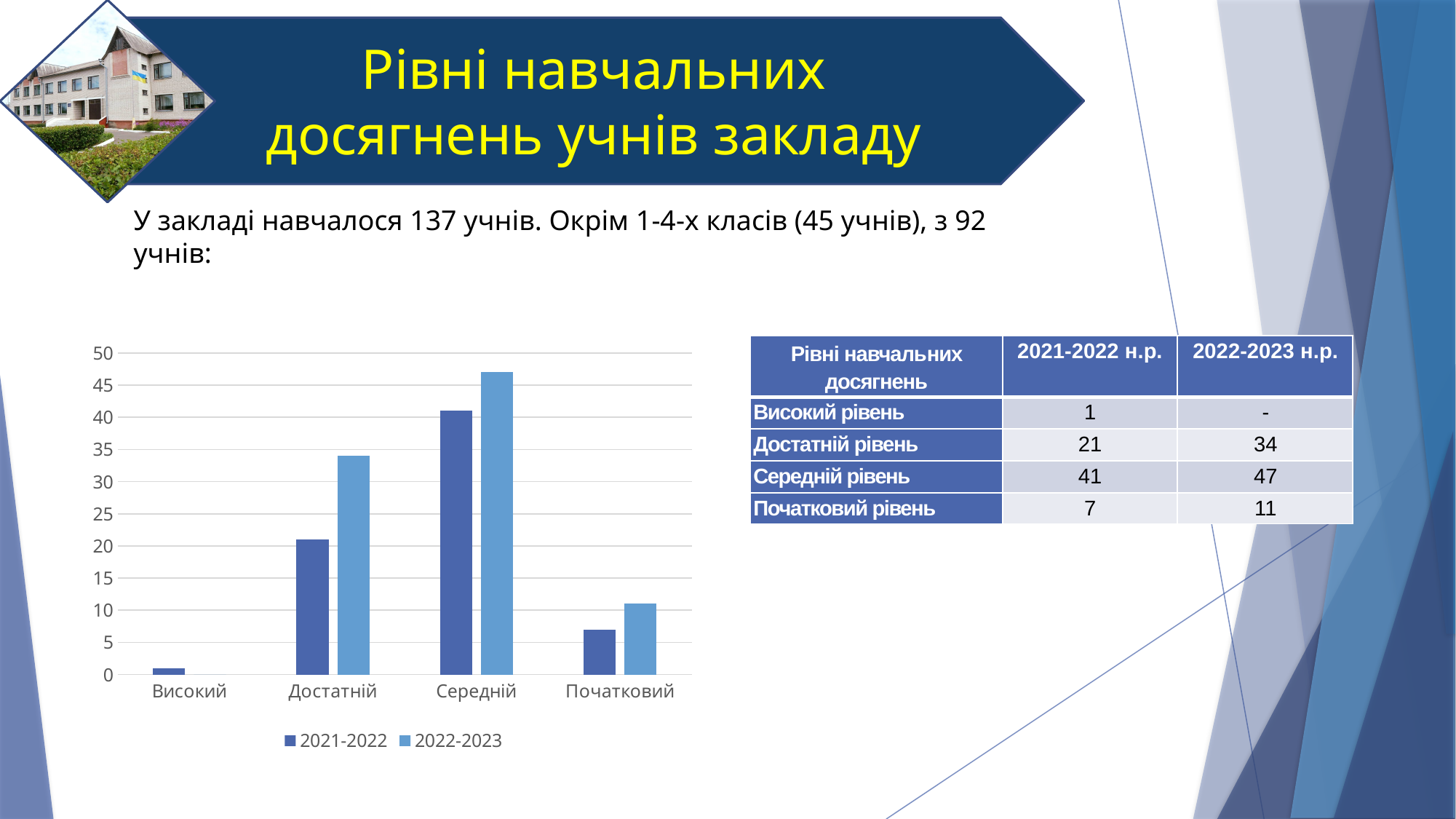
Is the value for Середній in the 2022-2023 series greater or less than 45? greater What is the difference between the 2022-2023 and 2021-2022 values for Достатній? 13 What is the value for Середній in the 2021-2022 series? 41 How many categories are shown on the x axis of the chart? 4 Which category has the highest value for the 2022-2023 series? Середній How many series does the chart legend list? 2 Which is larger for Початковий: the 2021-2022 value or the 2022-2023 value? 2022-2023 What is the value for Достатній in the 2022-2023 series? 34 Is the value for Початковий in the 2021-2022 series greater or less than 10? less Which category has the lowest value for the 2021-2022 series? Високий What kind of chart is shown on the slide? bar chart What are the two series names listed in the chart legend? 2021-2022 and 2022-2023